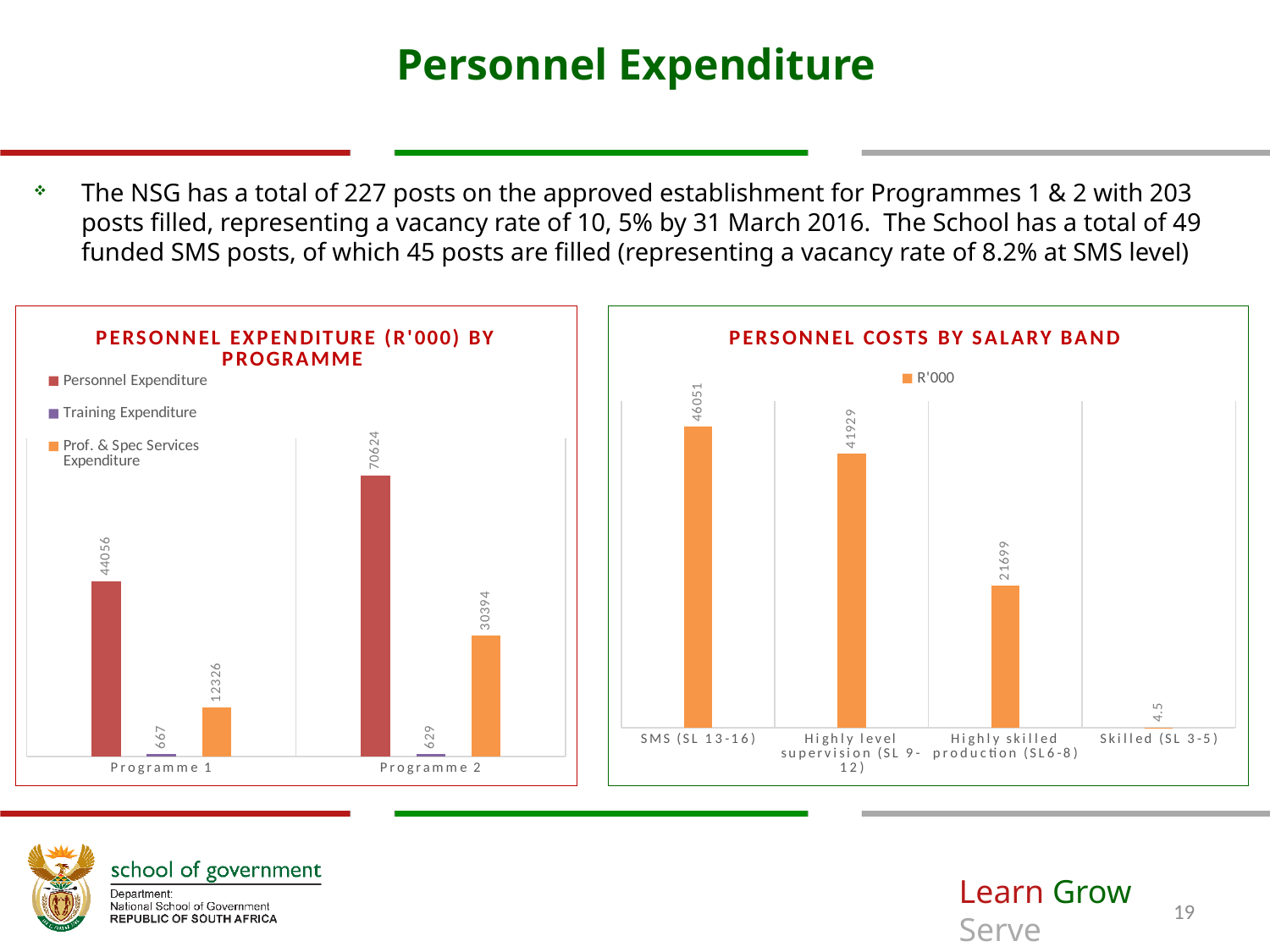
What type of chart is the 'Personnel Costs by Salary Band' chart? Bar chart In the 'Personnel Expenditure (R'000) by Programme' chart, which programme has the higher Prof. & Spec Services Expenditure? Programme 2 In the 'Personnel Expenditure (R'000) by Programme' chart, how many series does the legend list? 3 In the 'Personnel Costs by Salary Band' chart, which salary band has the highest personnel cost? SMS (SL 13-16) In the 'Personnel Costs by Salary Band' chart, what is the value for Highly skilled production (SL6-8)? 21699 In the 'Personnel Expenditure (R'000) by Programme' chart, what is the Training Expenditure value for Programme 1? 667 In the 'Personnel Costs by Salary Band' chart, how many salary bands are shown? 4 In the 'Personnel Expenditure (R'000) by Programme' chart, what is the difference between Personnel Expenditure for Programme 2 and Programme 1? 26568 In the 'Personnel Expenditure (R'000) by Programme' chart, what is the Prof. & Spec Services Expenditure value for Programme 2? 30394 In the 'Personnel Expenditure (R'000) by Programme' chart, which series is shown in red? Personnel Expenditure In the 'Personnel Costs by Salary Band' chart, which salary band has the lowest personnel cost? Skilled (SL 3-5) In the 'Personnel Expenditure (R'000) by Programme' chart, what is the Personnel Expenditure value for Programme 2? 70624